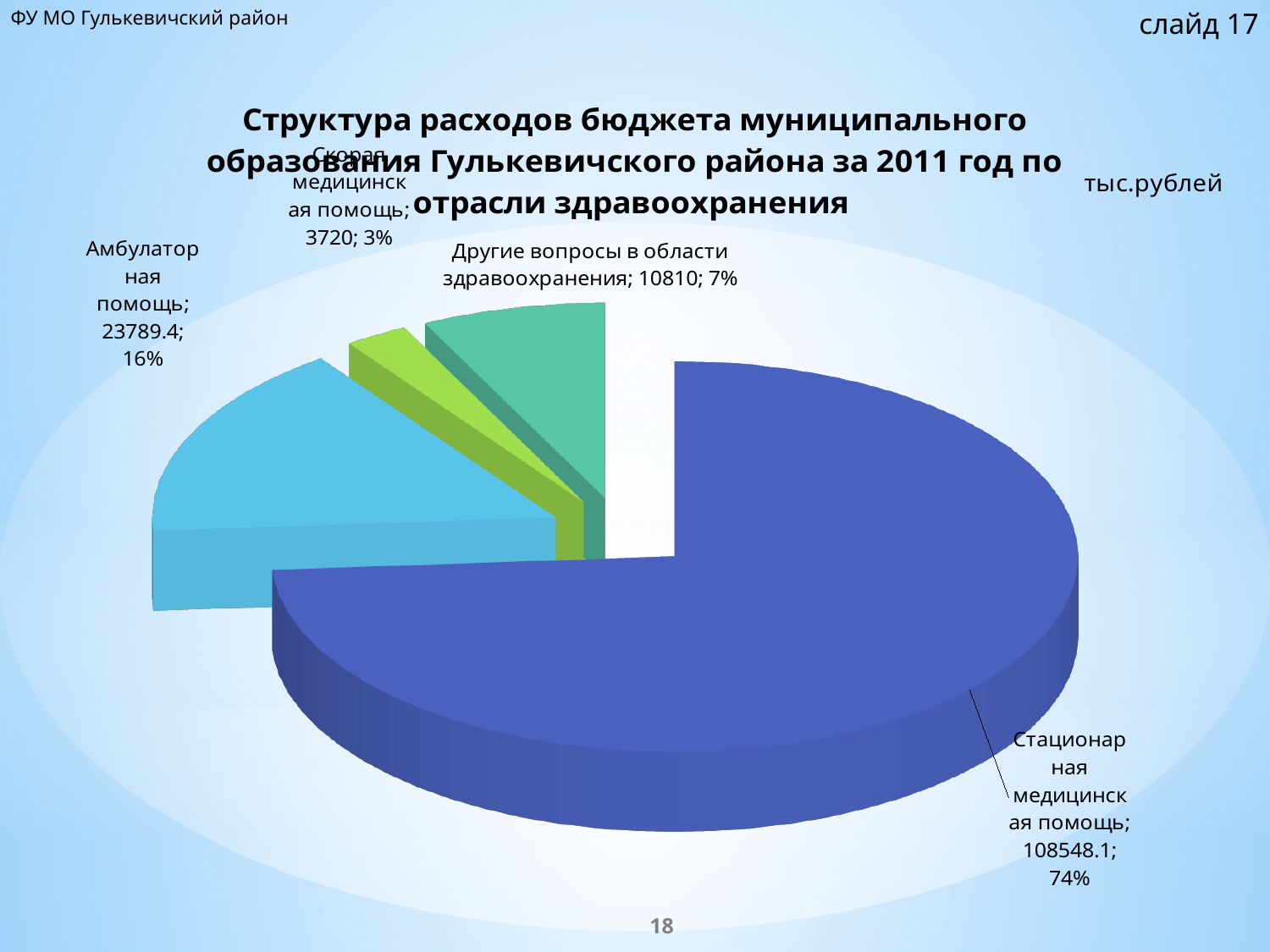
Which is larger, the value for Другие вопросы в области здравоохранения or the value for Скорая медицинская помощь? Другие вопросы в области здравоохранения What type of chart is shown on the slide? Pie chart What share of the pie does Амбулаторная помощь represent? 16% What share of the pie does Стационарная медицинская помощь represent? 74% What is the value for Амбулаторная помощь? 23789.4 What is the value for Другие вопросы в области здравоохранения? 10810 How many slices does the pie chart have? 4 Which category has the smallest slice of the pie? Скорая медицинская помощь In what units are the values on the chart expressed? тыс.рублей What is the value for Скорая медицинская помощь? 3720 What is the value for Стационарная медицинская помощь? 108548.1 Which category has the largest slice of the pie? Стационарная медицинская помощь